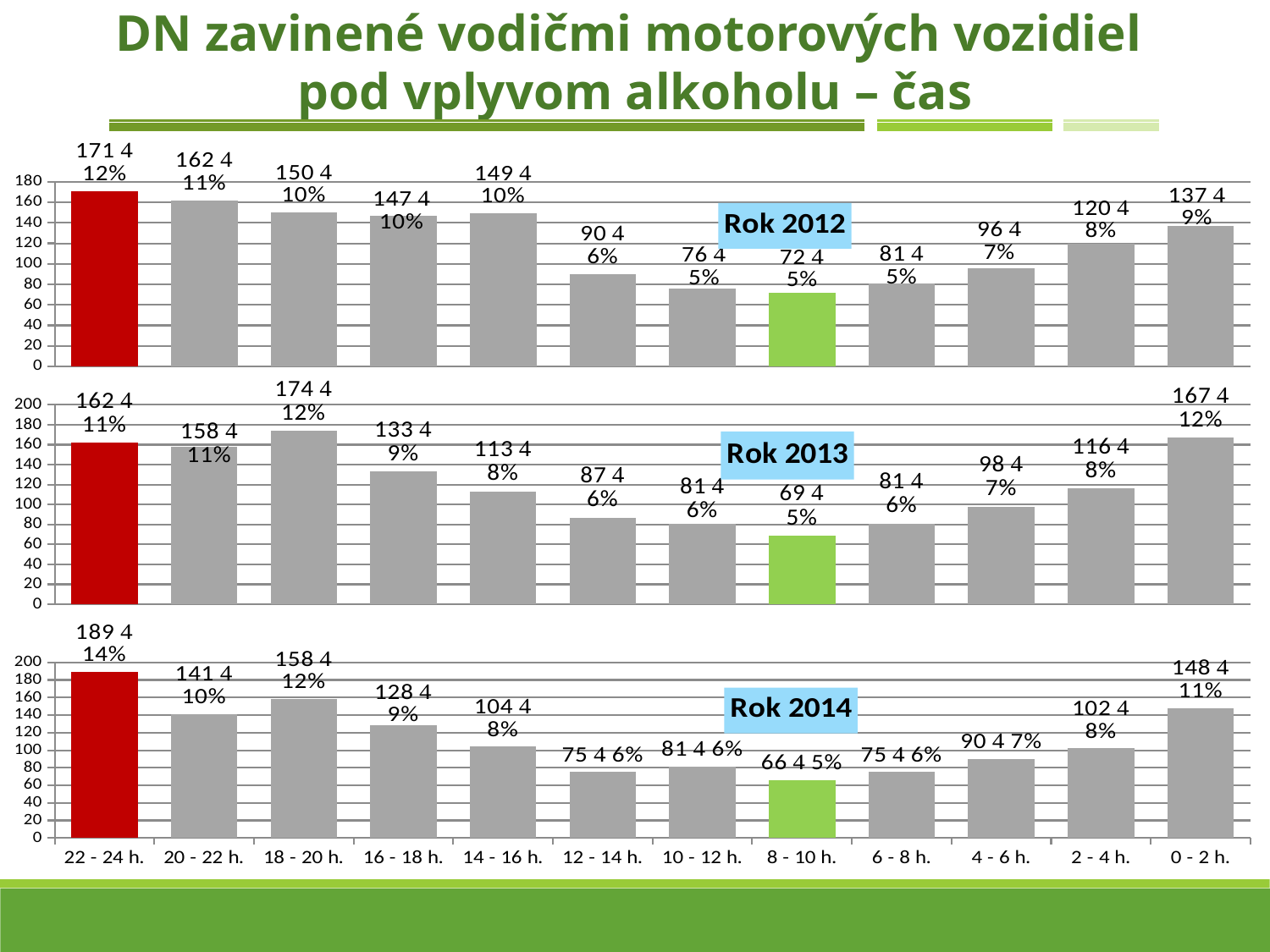
How many time intervals are shown on the x axis of each chart? 12 What kind of chart is the Rok 2013 chart? bar chart In the Rok 2013 chart, what percentage is shown for the 8 - 10 h. interval? 5% In the Rok 2012 chart, what colour is the bar for 22 - 24 h.? red In the Rok 2014 chart, is the value for 18 - 20 h. greater or less than 140? greater In the Rok 2014 chart, which time interval has the lowest value? 8 - 10 h. In the Rok 2013 chart, which time interval has the highest value? 18 - 20 h. In the Rok 2012 chart, which is larger: the value for 20 - 22 h. or the value for 0 - 2 h.? 20 - 22 h. In the Rok 2014 chart, what percentage is shown for the 22 - 24 h. interval? 14% In the Rok 2012 chart, which time interval has the lowest value? 8 - 10 h. In the Rok 2012 chart, what percentage is shown for the 2 - 4 h. interval? 8% In the Rok 2012 chart, which time interval has the highest value? 22 - 24 h.